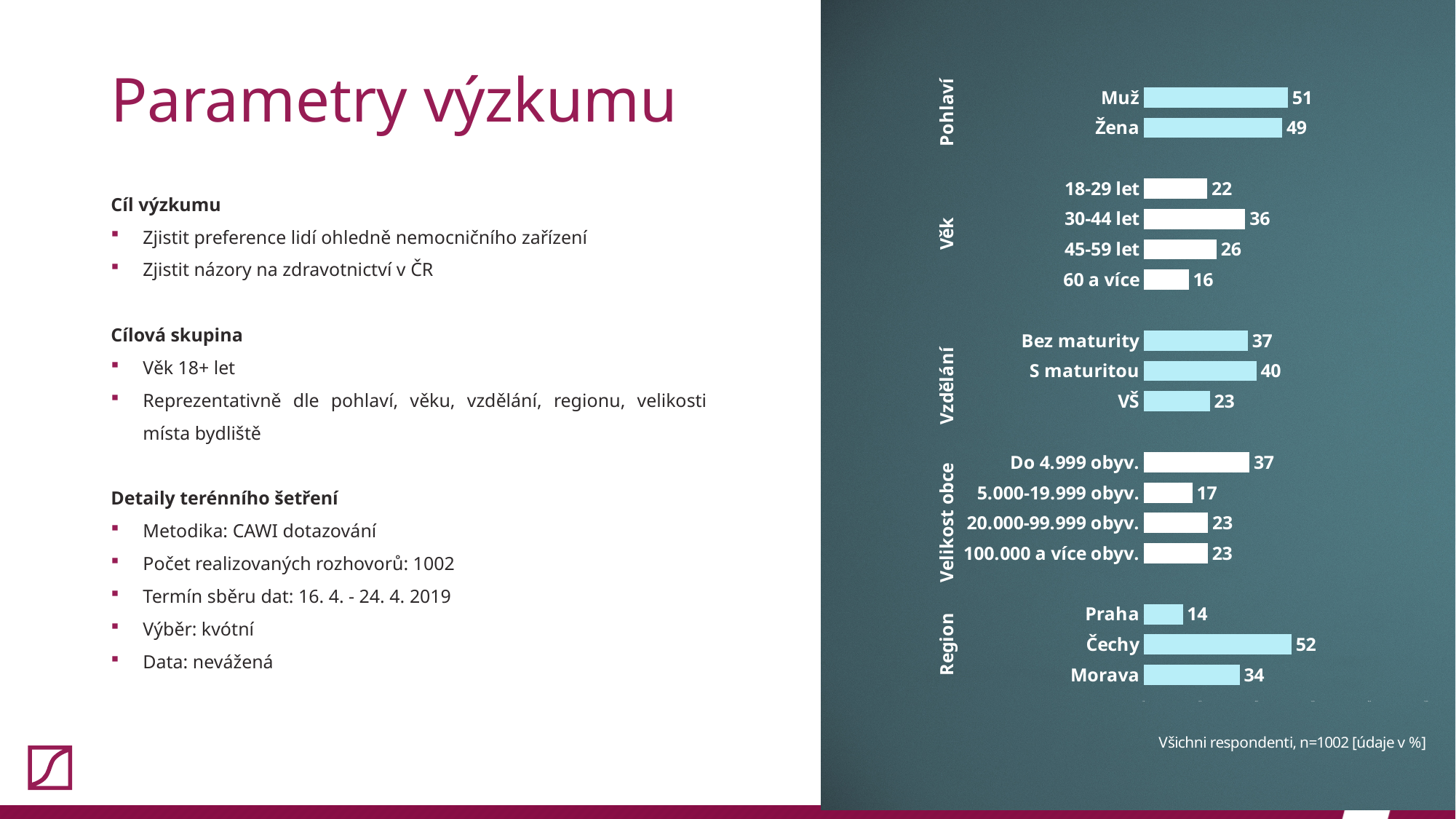
What note is printed below the chart about the respondents? Všichni respondenti, n=1002 [údaje v %] In the Vzdělání group of the chart, which is larger: Bez maturity or S maturitou? S maturitou In the Věk group of the chart, what is the total of the values for 18-29 let and 45-59 let? 48 In the Velikost obce group of the chart, what is the value for 5.000-19.999 obyv.? 17 In the Region group of the chart, what is the difference between the values for Čechy and Praha? 38 How many categories are shown in the Velikost obce group of the chart? 4 In the Vzdělání group of the chart, what is the value for VŠ? 23 In the Věk group of the chart, what is the value for 30-44 let? 36 In the Region group of the chart, which category has the highest value? Čechy In the Věk group of the chart, which category has the lowest value? 60 a více In the Pohlaví group of the chart, what is the value for Muž? 51 What kind of chart is shown on the slide? Bar chart